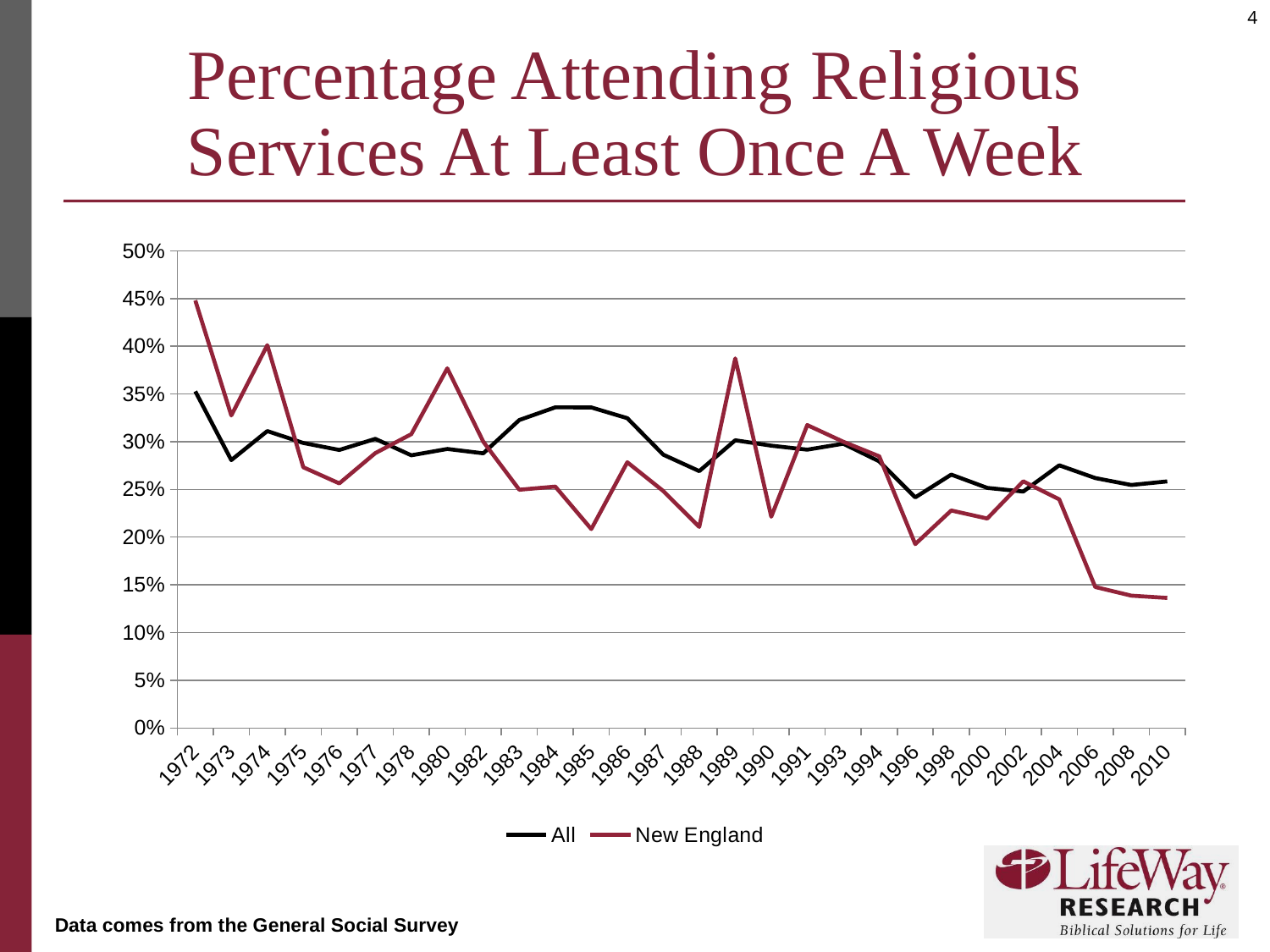
Is the All value for 2010 greater or less than 25%? greater Is the New England value for 2010 greater or less than 15%? less In 1985, which series has the higher value, All or New England? All What are the two series named in the legend? All and New England Is the New England value for 1972 greater or less than 40%? greater In 2010, which series has the higher value, All or New England? All In which year does the New England series reach its highest value? 1972 How many years are plotted along the x axis? 28 How many series does the legend list? 2 What kind of chart is shown on the slide? line chart Does the New England series generally rise or fall from 1972 to 2010? fall